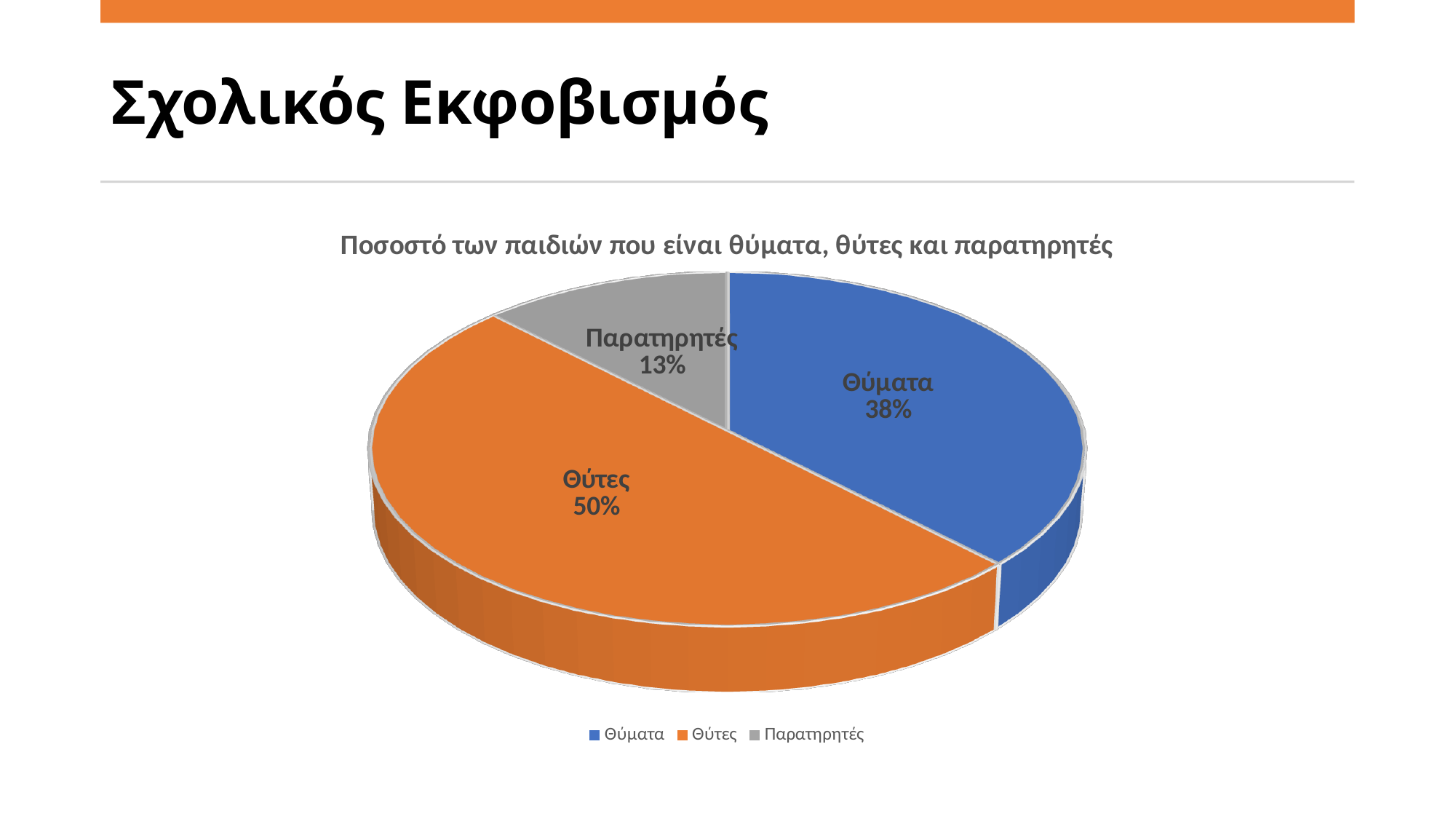
What percentage of the pie is labelled Θύματα? 38% What is the difference in percentage points between Θύτες and Θύματα? 12 What colour is the slice for Θύτες? Orange What percentage of the pie is labelled Παρατηρητές? 13% What is the title of the chart? Ποσοστό των παιδιών που είναι θύματα, θύτες και παρατηρητές How many slices does the pie chart have? 3 What is the difference in percentage points between Θύματα and Παρατηρητές? 25 What kind of chart is shown on the slide? Pie chart What percentage of the pie is labelled Θύτες? 50% Which category has the smallest slice of the pie? Παρατηρητές Which is larger, the slice for Θύματα or the slice for Παρατηρητές? Θύματα Which category has the largest slice of the pie? Θύτες